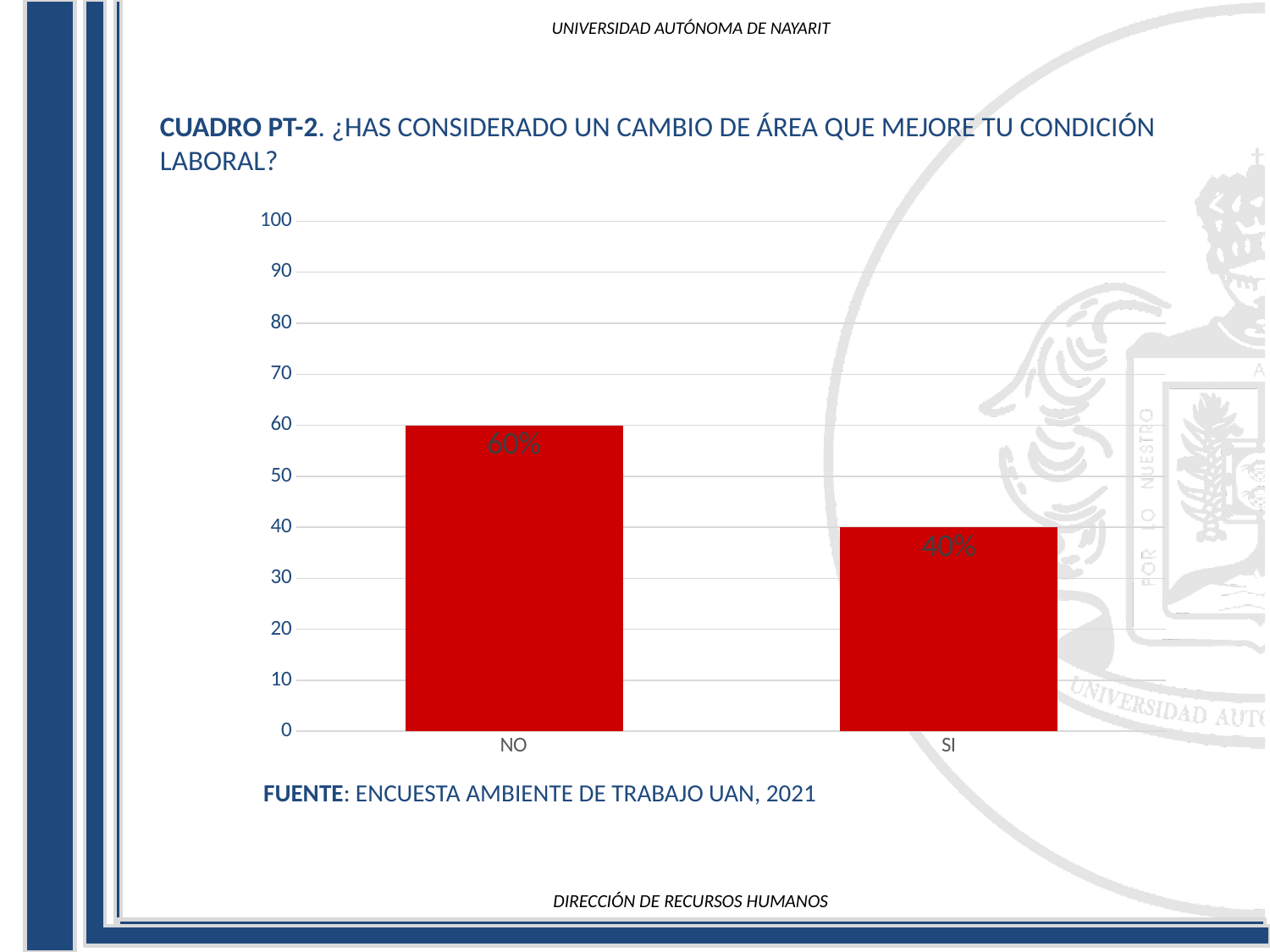
What is the value for NO? 60% Which is larger, the value for NO or the value for SI? NO How many categories are shown on the x axis? 2 What kind of chart is shown on the slide? bar chart What is the value for SI? 40% Which category has the highest value? NO Is the value for NO greater or less than 50? greater What colour are the bars in the chart? red What is the difference between the values for NO and SI? 20% Which category has the lowest value? SI Is the value for SI greater or less than 50? less What is the maximum value shown on the y axis? 100